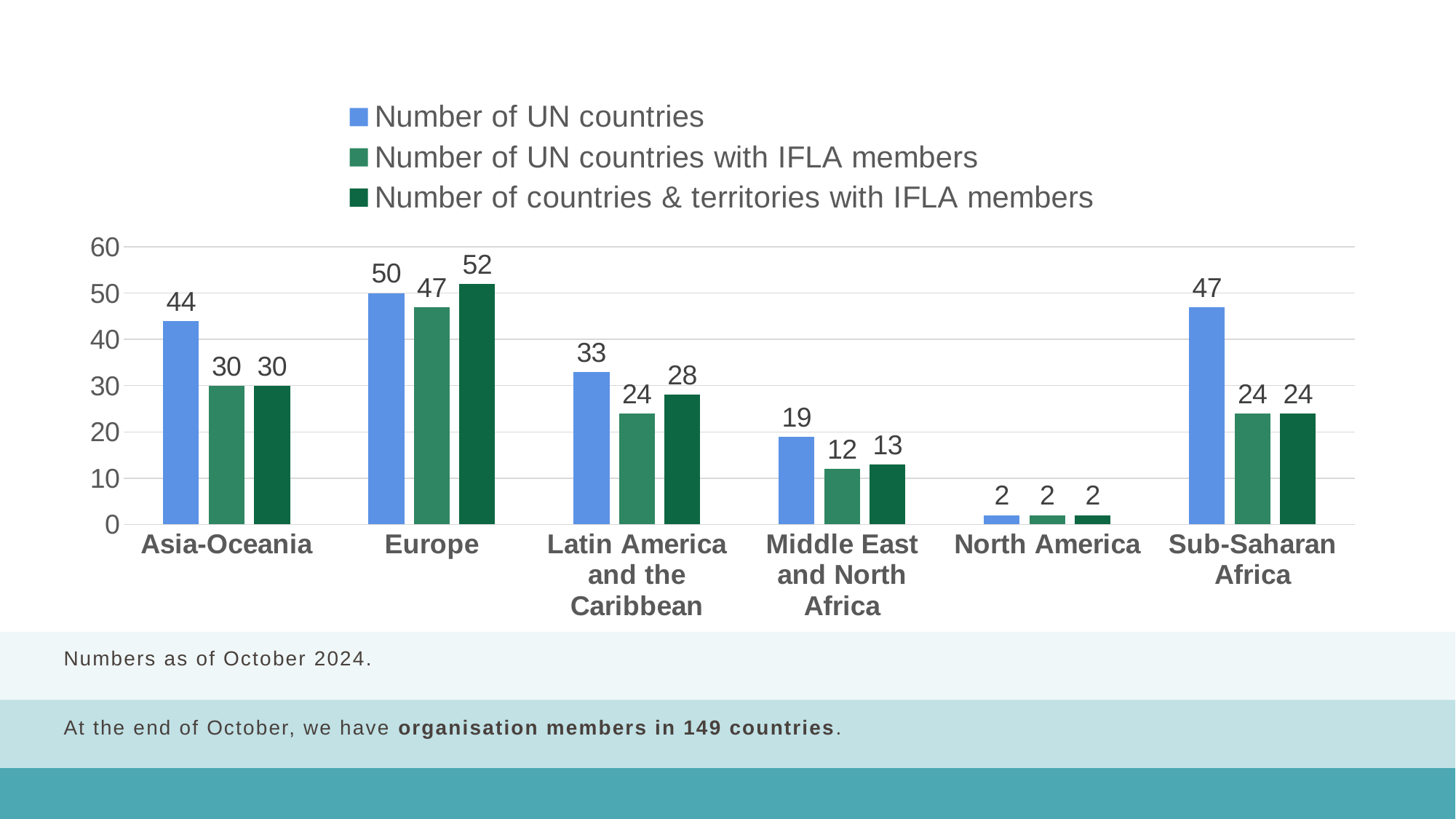
Which region has the lowest Number of UN countries with IFLA members? North America Which is larger for Asia-Oceania: the Number of UN countries or the Number of UN countries with IFLA members? Number of UN countries What is the difference between the Number of countries & territories with IFLA members and the Number of UN countries with IFLA members for Europe? 5 Which legend entry is shown in the darkest green colour? Number of countries & territories with IFLA members What kind of chart is shown on the slide? Bar chart What is the difference between the Number of UN countries and the Number of UN countries with IFLA members for Sub-Saharan Africa? 23 What is the Number of UN countries for Europe? 50 Which region has the highest Number of UN countries? Europe How many regions are shown on the x axis? 6 What is the Number of countries & territories with IFLA members for Middle East and North Africa? 13 How many series does the legend list? 3 What is the Number of UN countries with IFLA members for Latin America and the Caribbean? 24